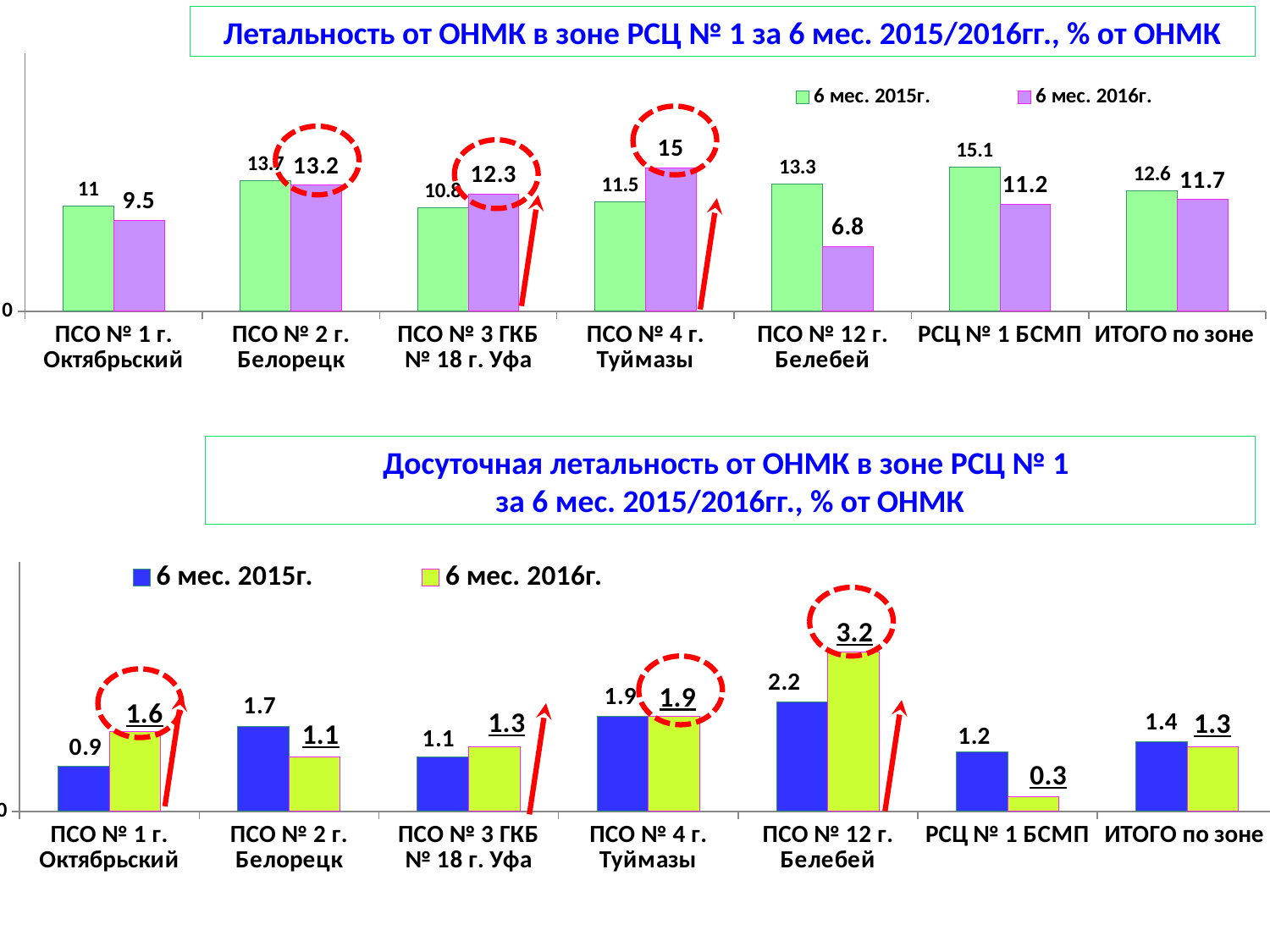
In the top chart (Летальность от ОНМК в зоне РСЦ № 1), what is the value for РСЦ № 1 БСМП for 6 мес. 2015г.? 15.1 In the bottom chart (Досуточная летальность от ОНМК), what is the value for ИТОГО по зоне for 6 мес. 2015г.? 1.4 In the top chart (Летальность от ОНМК в зоне РСЦ № 1), how many categories are shown on the x axis? 7 In the bottom chart (Досуточная летальность от ОНМК), which category has the highest value for 6 мес. 2015г.? ПСО № 12 г. Белебей In the top chart (Летальность от ОНМК в зоне РСЦ № 1), what is the difference between the 6 мес. 2015г. and 6 мес. 2016г. values for ПСО № 12 г. Белебей? 6.5 In the bottom chart (Досуточная летальность от ОНМК), how many series does the legend list? 2 In the top chart (Летальность от ОНМК в зоне РСЦ № 1), which category has the lowest value for 6 мес. 2016г.? ПСО № 12 г. Белебей In the top chart (Летальность от ОНМК в зоне РСЦ № 1), which is larger for ПСО № 3 ГКБ № 18 г. Уфа: the 6 мес. 2015г. value or the 6 мес. 2016г. value? 6 мес. 2016г. What kind of chart is the bottom chart (Досуточная летальность от ОНМК)? Bar chart In the bottom chart (Досуточная летальность от ОНМК), what is the value for ПСО № 12 г. Белебей for 6 мес. 2016г.? 3.2 In the bottom chart (Досуточная летальность от ОНМК), what is the difference between the 6 мес. 2016г. and 6 мес. 2015г. values for ПСО № 1 г. Октябрьский? 0.7 In the top chart (Летальность от ОНМК в зоне РСЦ № 1), what is the value for ПСО № 4 г. Туймазы for 6 мес. 2016г.? 15